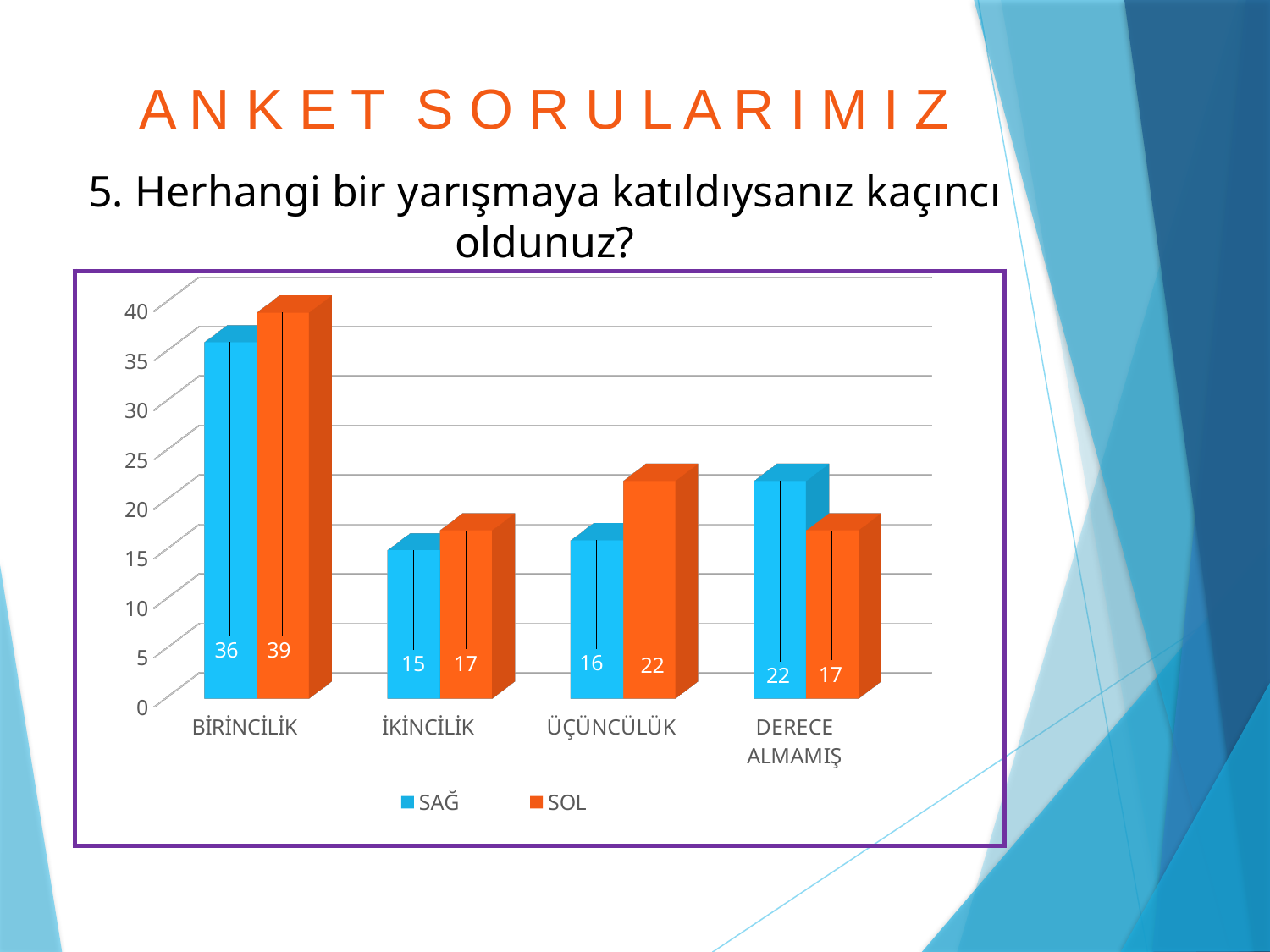
What colour represents the SOL series? orange How many series does the legend list? 2 What is the SOL value for ÜÇÜNCÜLÜK? 22 Which category has the lowest SAĞ value? İKİNCİLİK How many categories are shown on the x axis? 4 What is the SOL value for DERECE ALMAMIŞ? 17 Is the SOL value for BİRİNCİLİK greater or less than 35? greater What is the SAĞ value for BİRİNCİLİK? 36 What is the difference between the SOL and SAĞ values for ÜÇÜNCÜLÜK? 6 Which category has the highest SOL value? BİRİNCİLİK For DERECE ALMAMIŞ, which series has the larger value, SAĞ or SOL? SAĞ What kind of chart is shown on the slide? bar chart